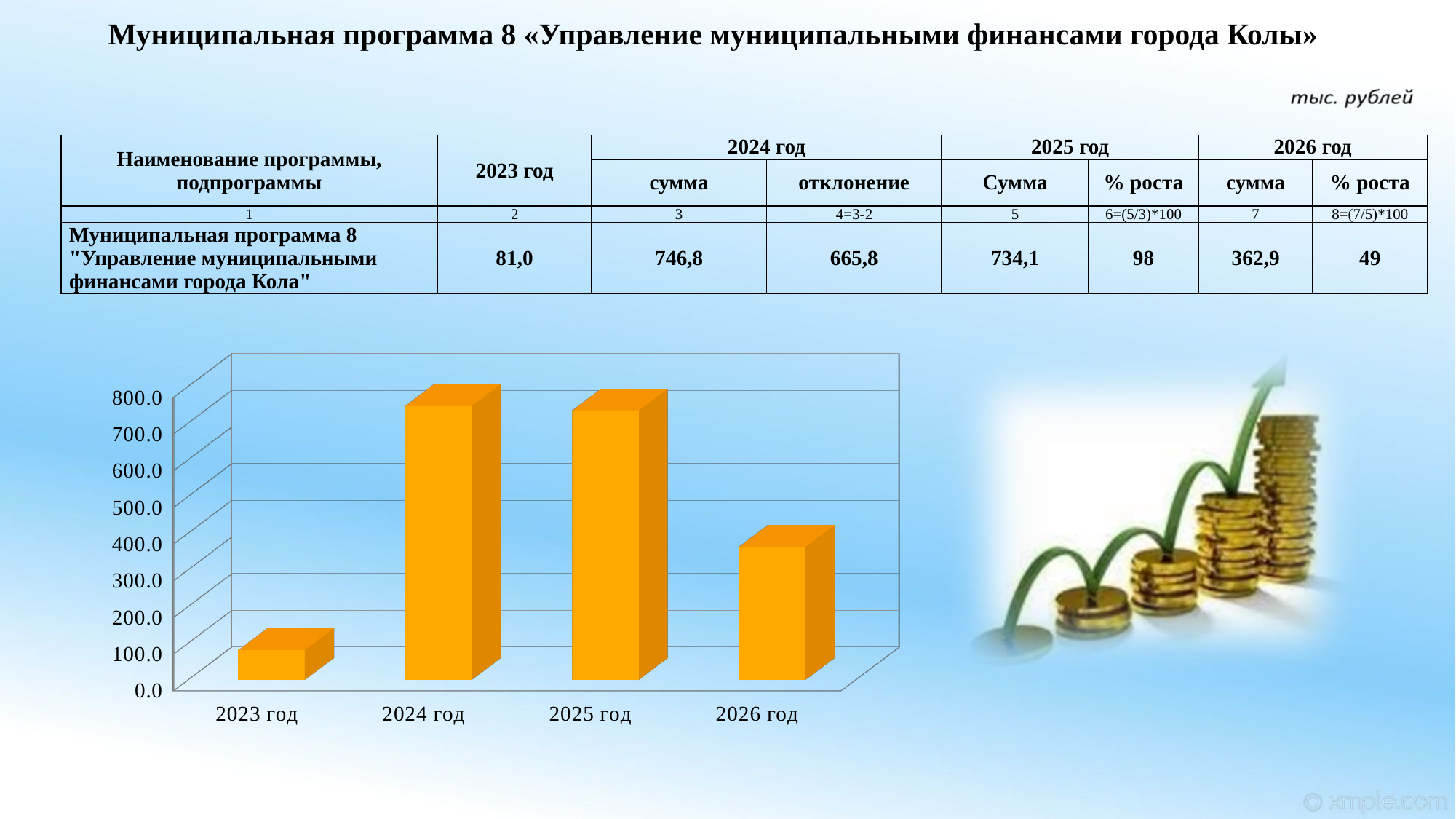
Which year has the lowest bar in the chart? 2023 год Which is larger, the bar for 2024 год or the bar for 2026 год? 2024 год What is the highest value shown on the chart's vertical axis? 800.0 Is the value for 2023 год greater or less than 100.0? less Is the value for 2026 год greater or less than 400.0? less Which is larger, the bar for 2023 год or the bar for 2025 год? 2025 год Is the value for 2024 год greater or less than 700.0? greater According to the table on the slide, what is the сумма for 2026 год? 362,9 What kind of chart is shown on the slide? bar chart According to the table on the slide, what is the value for 2023 год (тыс. рублей)? 81,0 How many bars (years) does the chart show? 4